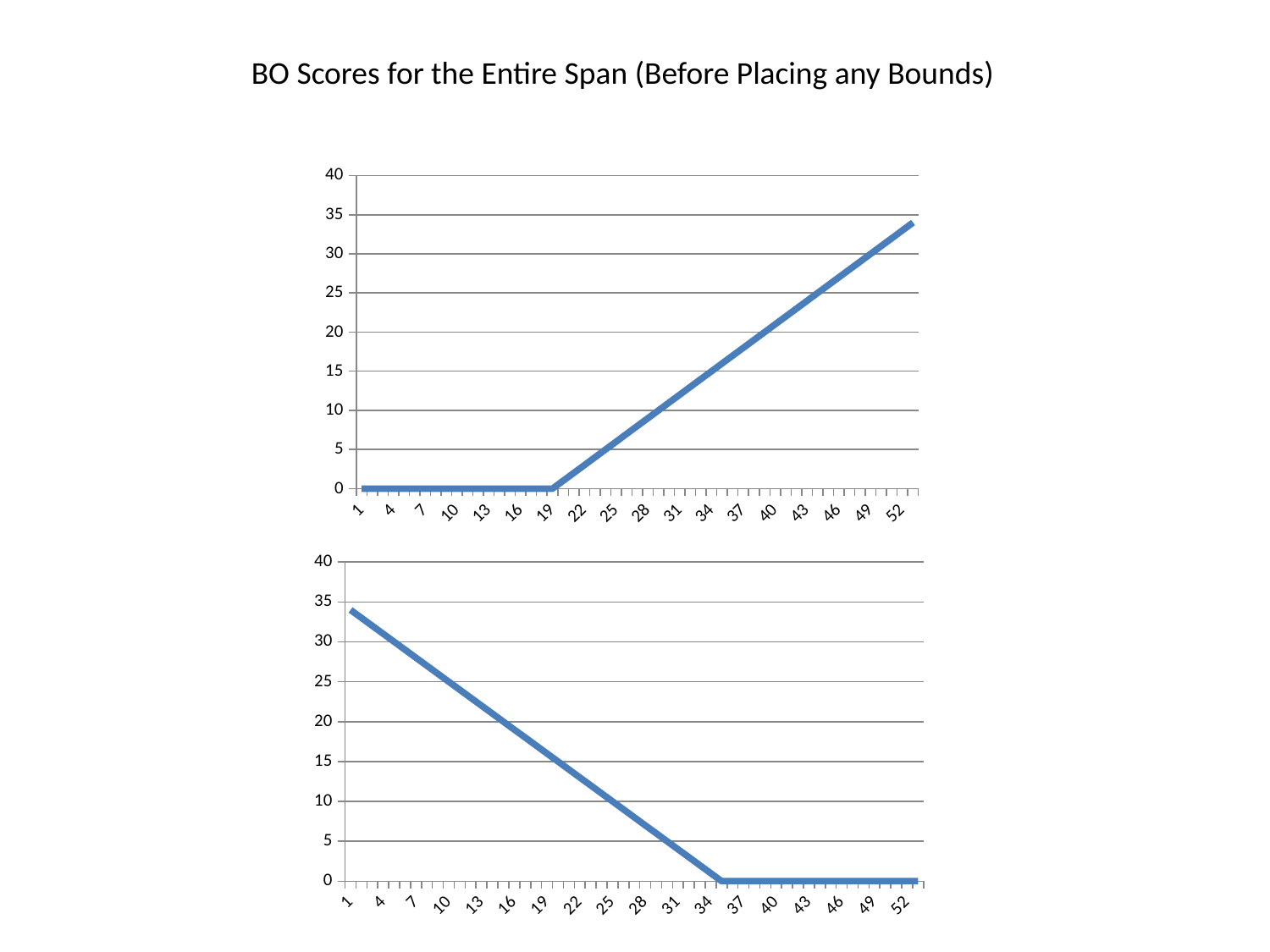
In the top chart, is the value at x = 10 greater or less than 5? less In the top chart, which is larger, the value at x = 4 or the value at x = 49? x = 49 What kind of chart is the top chart on the slide? line chart In the bottom chart, what is the value at x = 52? 0 In the top chart, do the values rise or fall along the x axis from 19 to 52? rise In the top chart, is the value at x = 52 greater or less than 30? greater In the bottom chart, is the value at x = 13 greater or less than 20? greater In the top chart, what is the value at x = 1? 0 In the bottom chart, do the values rise or fall along the x axis from 1 to 34? fall What is the title shown at the top of the slide? BO Scores for the Entire Span (Before Placing any Bounds)